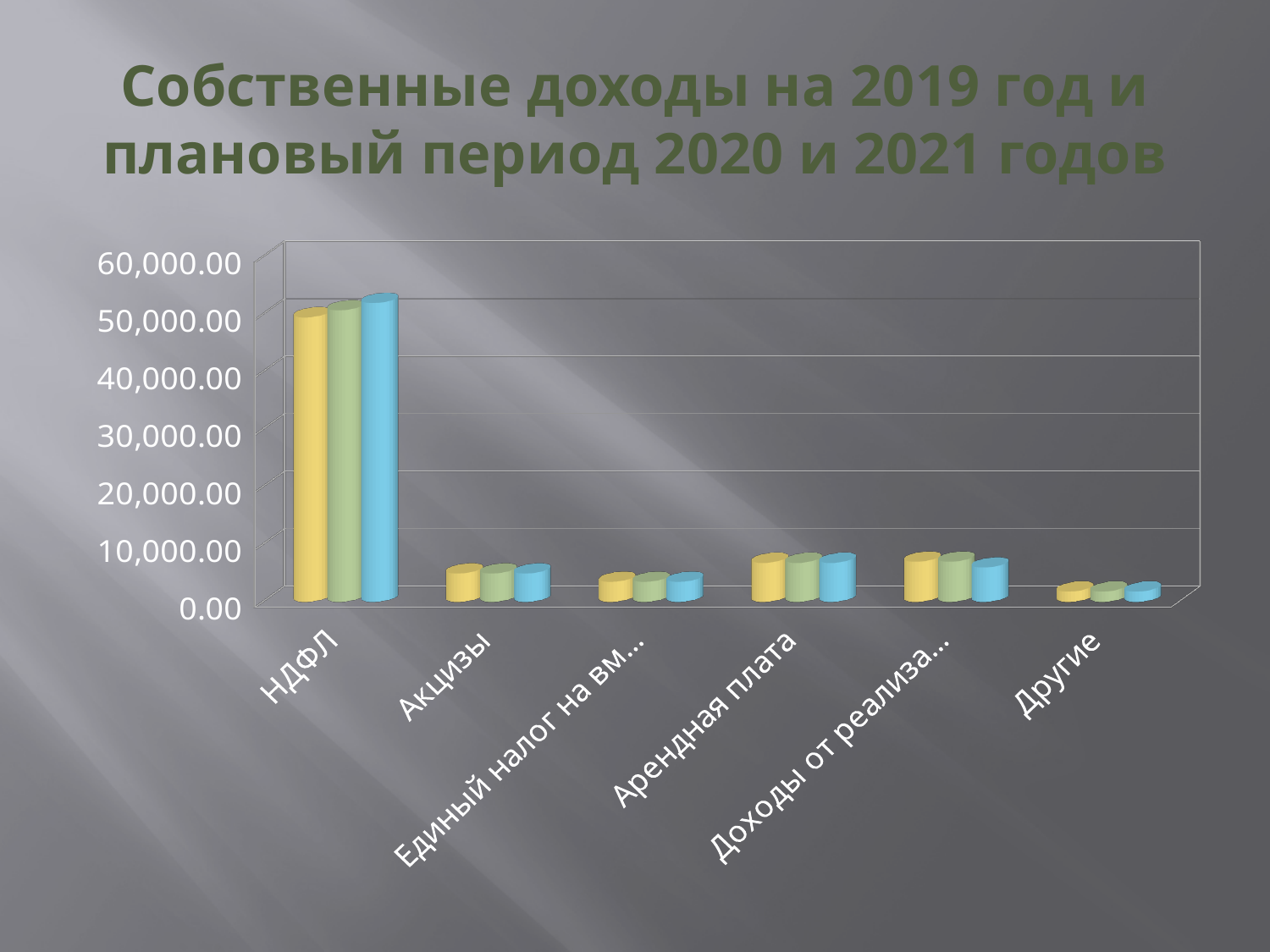
Do the three bars for НДФЛ rise or fall from left to right? rise Are the values for НДФЛ greater or less than 40,000.00? greater What is the title of the slide? Собственные доходы на 2019 год и плановый период 2020 и 2021 годов Which category has the lowest values in the chart? Другие Which category has the highest values in the chart? НДФЛ Which category has larger values, Арендная плата or Другие? Арендная плата How many bars are plotted for the category НДФЛ? 3 Are the values for Другие greater or less than 10,000.00? less How many categories are shown on the x axis of the chart? 6 Which category has larger values, НДФЛ or Акцизы? НДФЛ What kind of chart is shown on the slide? bar chart Are the values for Акцизы greater or less than 10,000.00? less